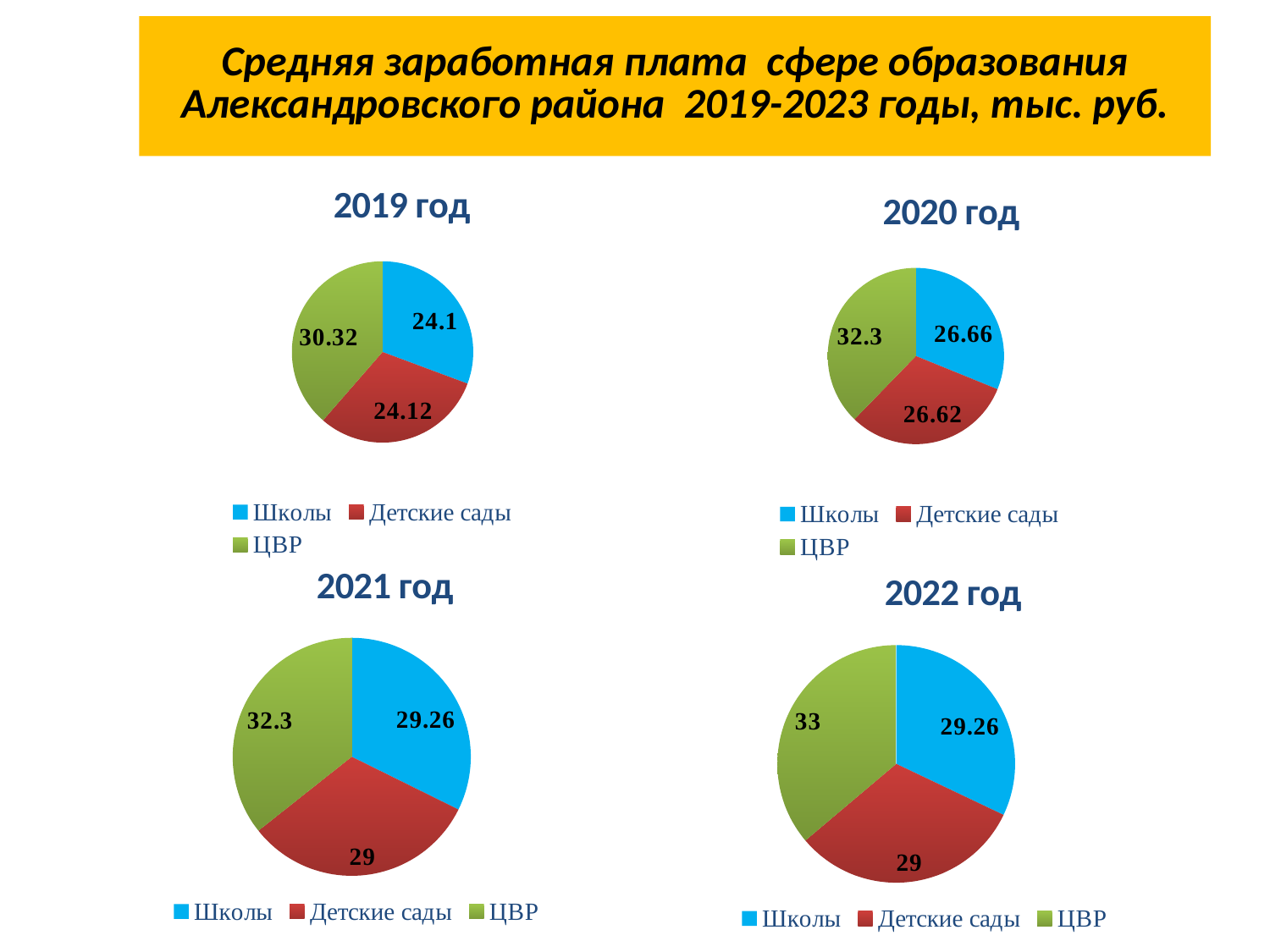
In the 2020 год chart, which category has the largest slice? ЦВР In the 2021 год chart, which is larger, the value for ЦВР or the value for Детские сады? ЦВР In the 2019 год chart, what is the value for Школы? 24.1 In the 2019 год chart, what is the difference between the values for ЦВР and Школы? 6.22 In the 2019 год chart, what is the value for ЦВР? 30.32 What kind of chart is the 2021 год chart? Pie chart In the 2022 год chart, which category has the largest slice? ЦВР In the 2021 год chart, what is the value for Школы? 29.26 In the 2022 год chart, what is the value for ЦВР? 33 In the 2020 год chart, what is the value for Детские сады? 26.62 How many slices does the 2020 год chart have? 3 In the 2022 год chart, what is the difference between the values for ЦВР and Детские сады? 4